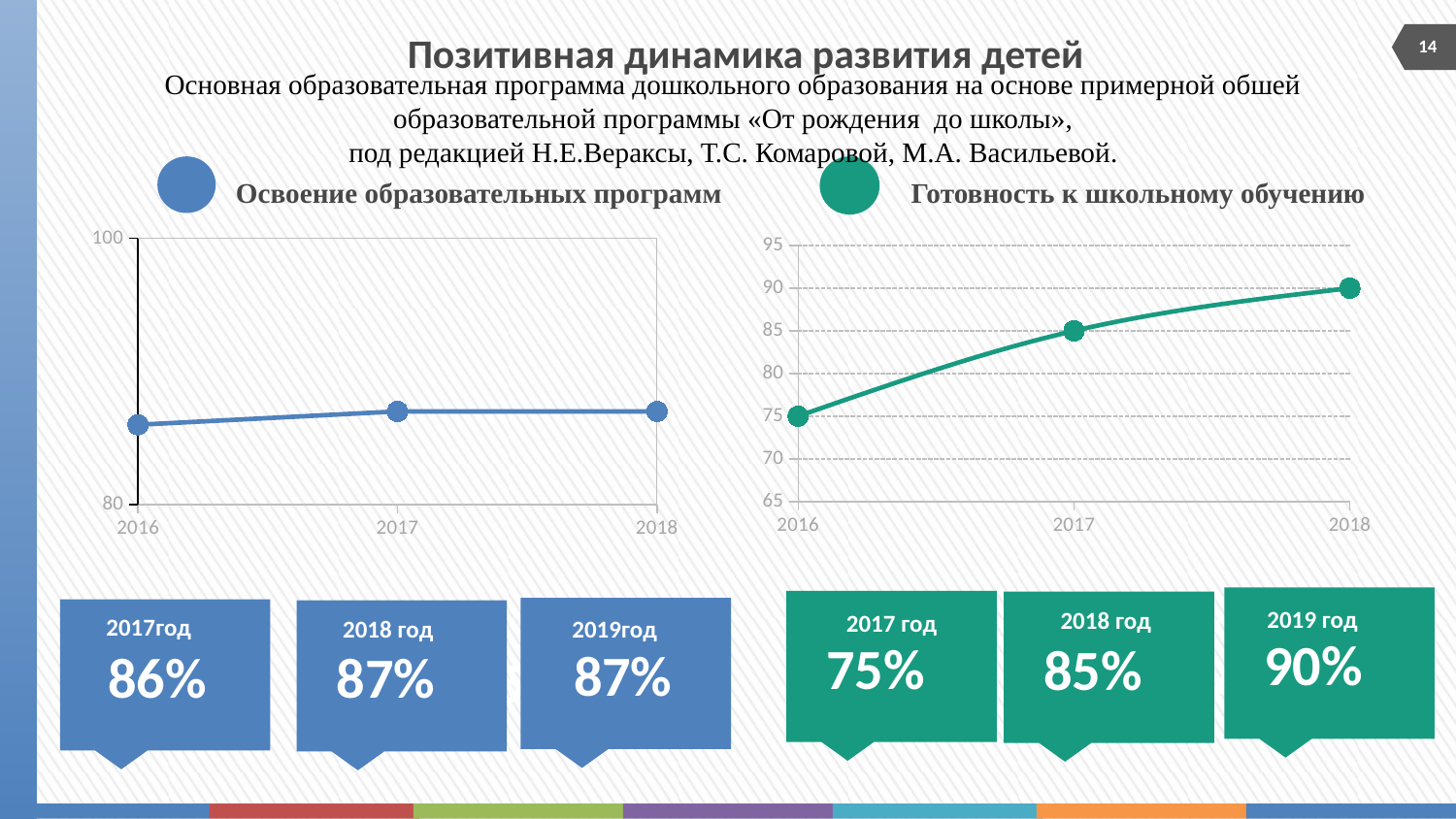
On the chart «Готовность к школьному обучению», what is the difference between the values for 2018 and 2016? 15 What kind of chart is the chart titled «Освоение образовательных программ»? line chart What kind of chart is the chart titled «Готовность к школьному обучению»? line chart On the chart «Готовность к школьному обучению», what is the value for 2018? 90 How many data points are plotted on the chart «Освоение образовательных программ»? 3 On the chart «Освоение образовательных программ», is the value for 2017 greater or less than 100? less On the chart «Освоение образовательных программ», is the value for 2016 greater or less than 80? greater On the chart «Готовность к школьному обучению», which year has the lowest value? 2016 On the chart «Готовность к школьному обучению», what is the value for 2016? 75 On the chart «Готовность к школьному обучению», which year has the highest value? 2018 On the chart «Готовность к школьному обучению», what is the value for 2017? 85 On the chart «Готовность к школьному обучению», do the values rise or fall from 2016 to 2018? rise